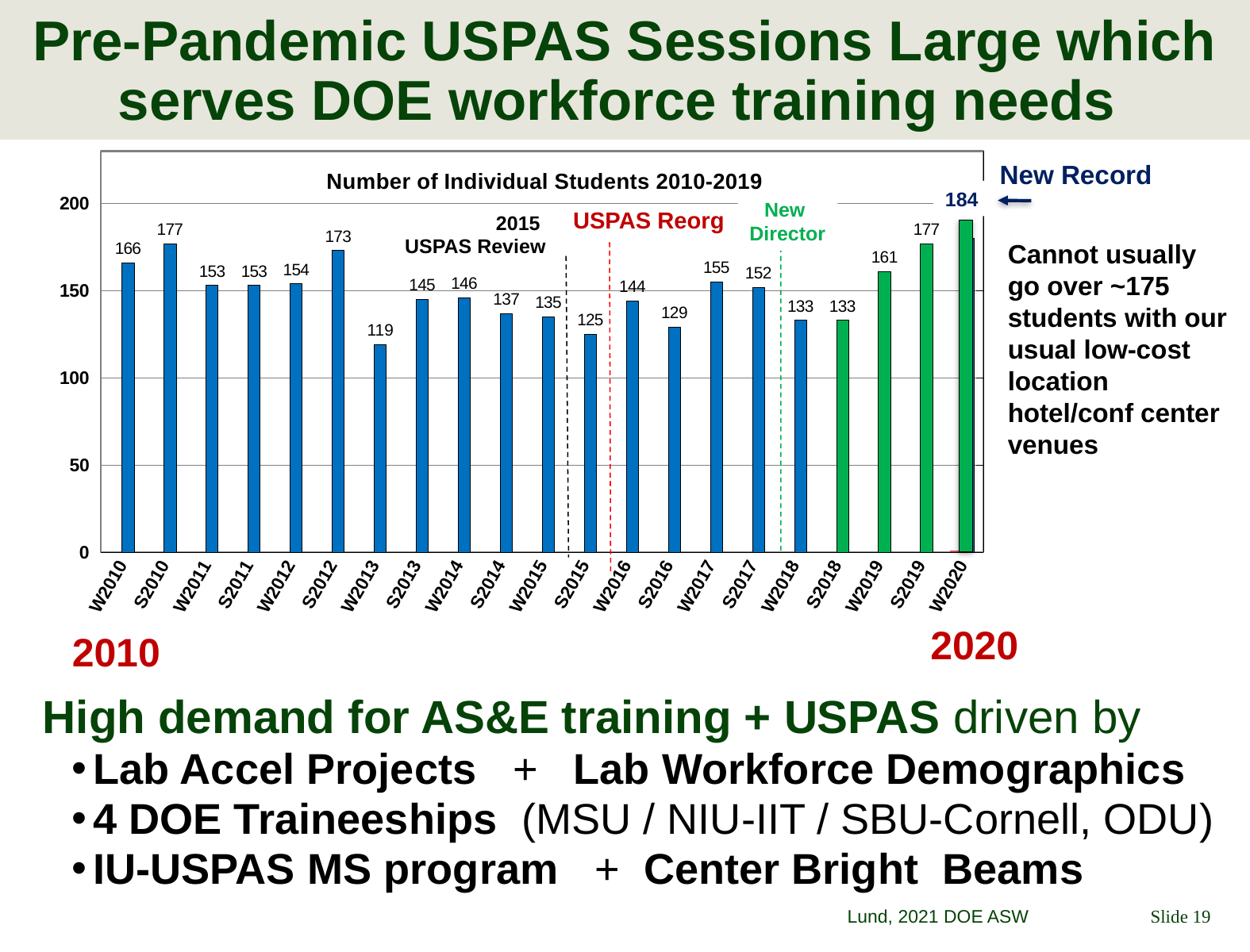
Which session has the highest number of individual students? W2020 What is the difference in students between S2019 and S2018? 44 What is the title of the chart? Number of Individual Students 2010-2019 Which session had more students, W2017 or S2017? W2017 What is the number of individual students for W2013? 119 How many sessions (bars) are plotted in the chart? 21 Which session has the lowest number of individual students? W2013 What type of chart is shown on the slide? bar chart What is the number of individual students for W2020? 184 What is the difference in students between W2010 and S2010? 11 What is the number of individual students for S2012? 173 Is the value for S2015 greater or less than 150? less